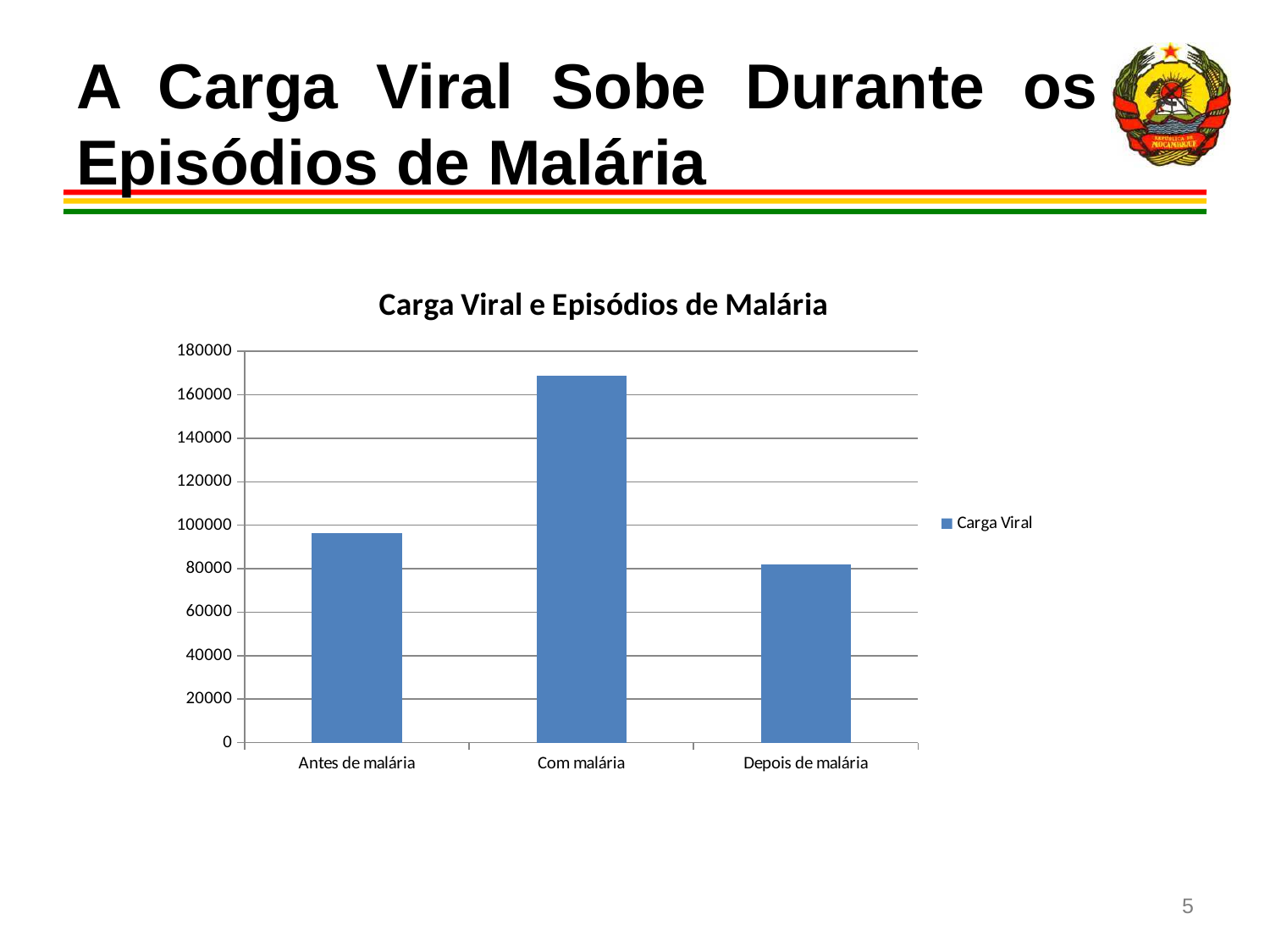
What series name appears in the chart's legend? Carga Viral What is the title of the chart? Carga Viral e Episódios de Malária How many categories are shown on the x axis of the chart? 3 Which category has the lowest Carga Viral value? Depois de malária What kind of chart is shown on the slide? bar chart Which category has the highest Carga Viral value? Com malária Is the value for Antes de malária greater or less than 100000? less Is the value for Antes de malária greater or less than 80000? greater Is the value for Depois de malária greater or less than 100000? less Which is larger, the value for Antes de malária or the value for Depois de malária? Antes de malária How many series does the chart's legend list? 1